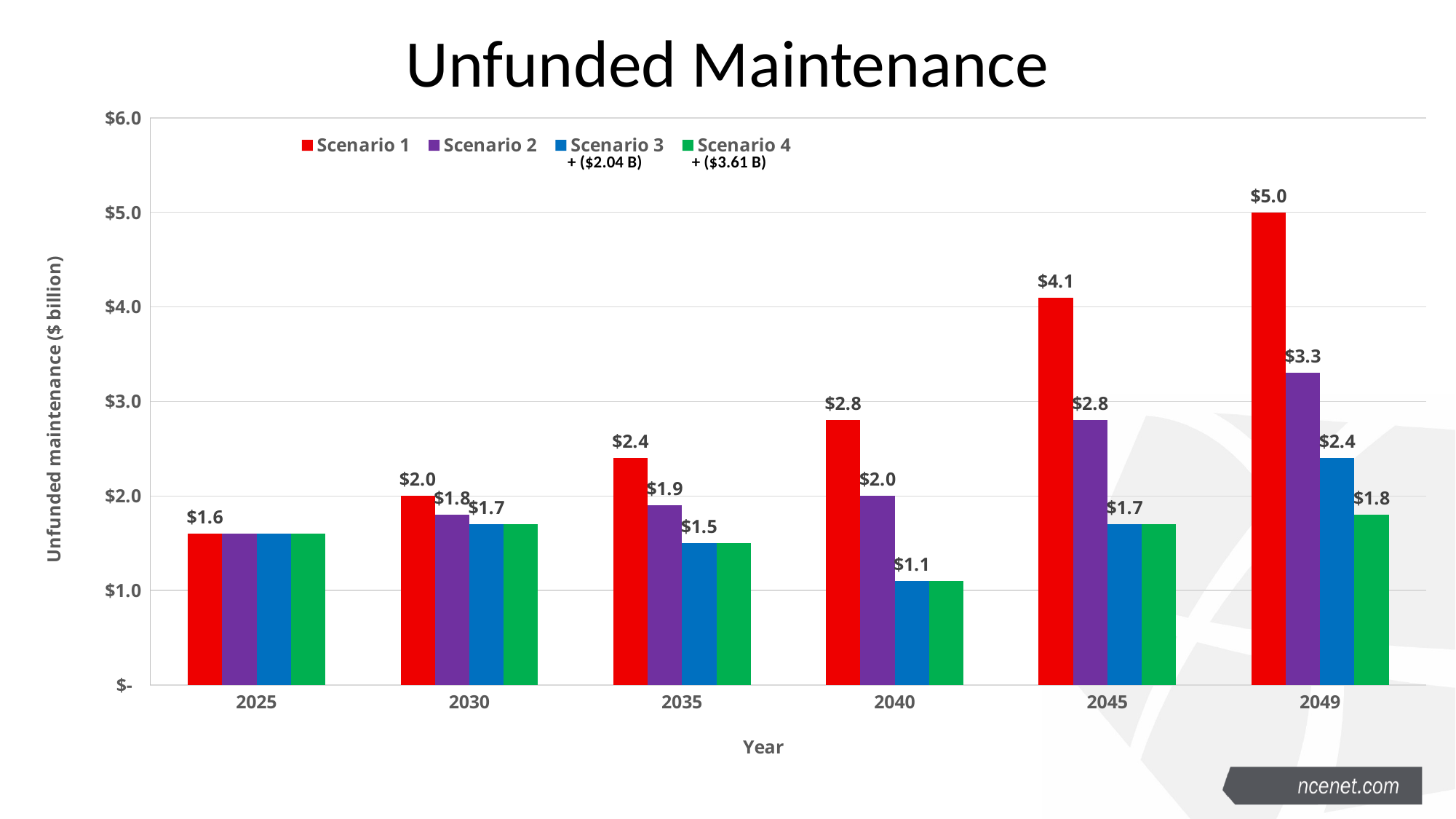
Do the Scenario 1 values rise or fall from 2025 to 2049? rise What is the value for Scenario 1 in 2049? $5.0 How many series does the legend list? 4 How many years are shown on the x axis? 6 Which is larger: Scenario 1 in 2045 or Scenario 2 in 2049? Scenario 1 in 2045 Is the value for Scenario 3 in 2049 greater or less than $2.0? greater What is the difference between Scenario 1 and Scenario 2 in 2049? $1.7 What kind of chart is shown on the slide? bar chart What is the value for Scenario 2 in 2045? $2.8 What is the value for Scenario 4 in 2049? $1.8 What is the value for Scenario 3 in 2040? $1.1 In which year is the Scenario 1 value highest? 2049